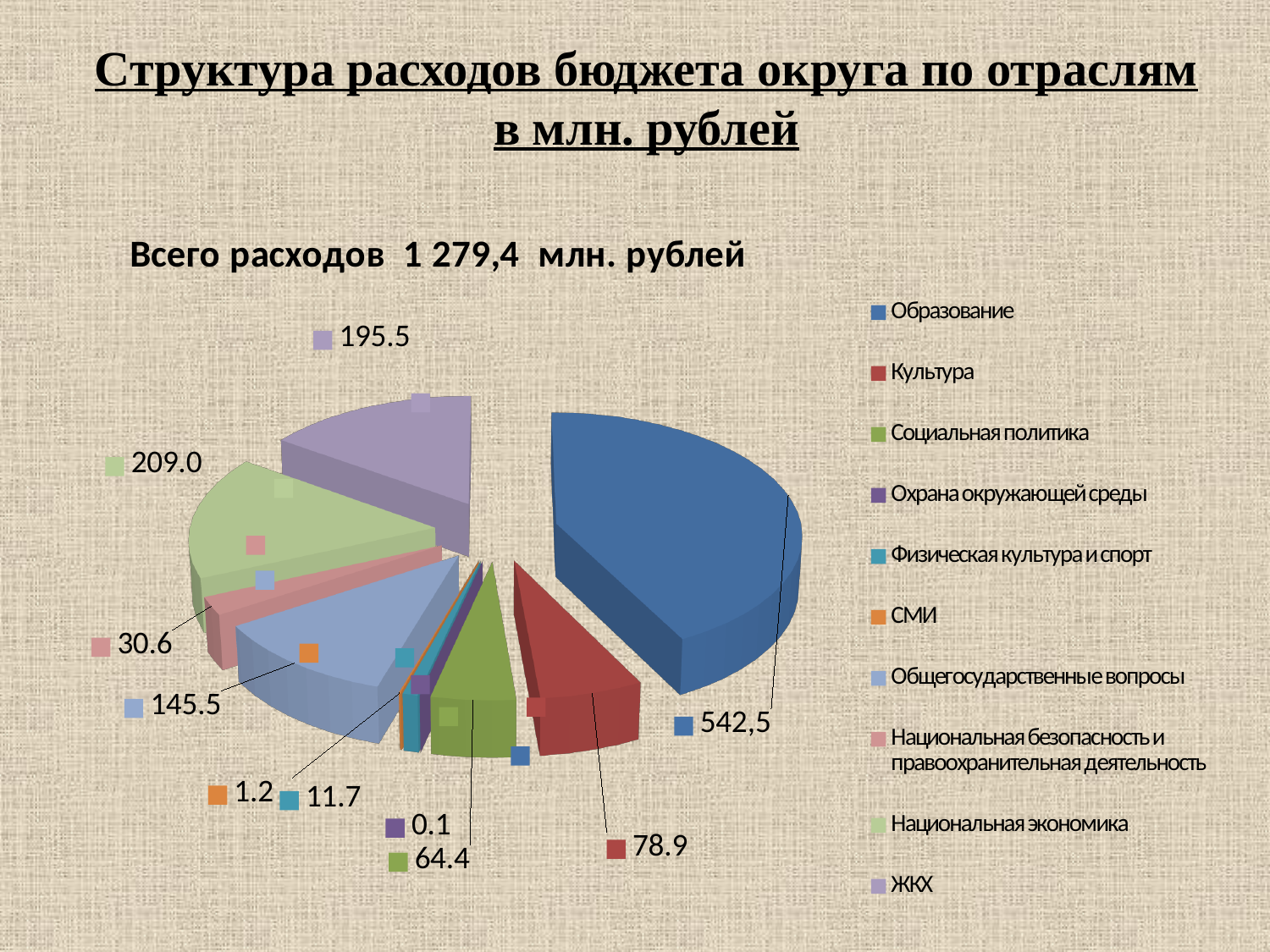
What is the value for Образование? 542,5 Which is larger, the value for Культура or the value for Социальная политика? Культура How many categories does the legend list? 10 What kind of chart is shown on the slide? pie chart What is the value for Общегосударственные вопросы? 145.5 What is the value for ЖКХ? 195.5 Which category has the largest slice of the pie? Образование What is the value for Национальная экономика? 209.0 What is the value for Физическая культура и спорт? 11.7 What total expenditure is stated on the slide? 1 279,4 млн. рублей Which category has the smallest value? Охрана окружающей среды What is the difference between the values for Национальная экономика and ЖКХ? 13.5